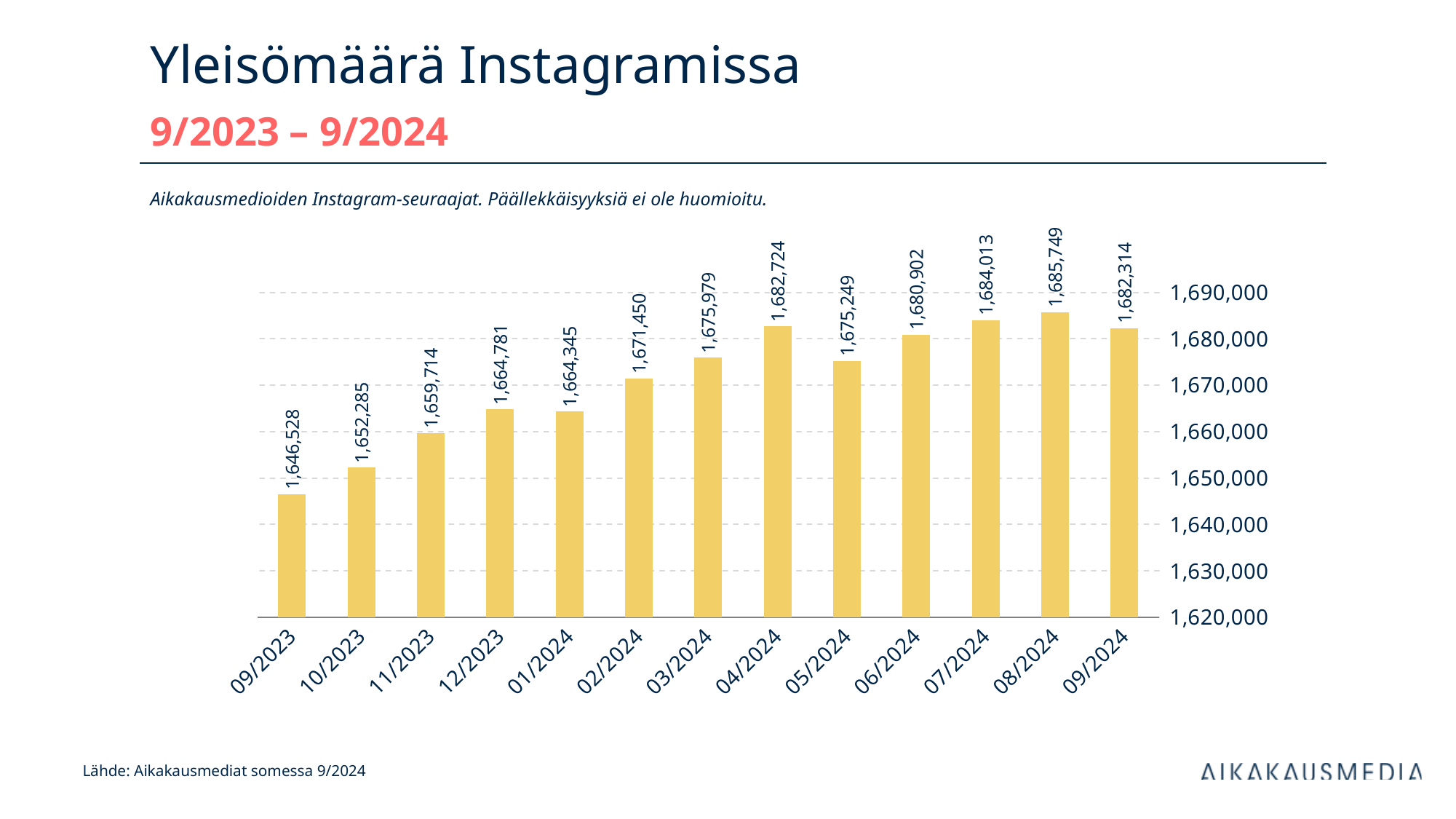
Which month has the highest value? 08/2024 What is the difference between the values for 09/2024 and 09/2023? 35,786 What is the value for 09/2023? 1,646,528 What is the value for 04/2024? 1,682,724 What is the difference between the values for 08/2024 and 07/2024? 1,736 How many months are shown on the x axis? 13 What is the value for 09/2024? 1,682,314 Which is larger, the value for 04/2024 or the value for 05/2024? 04/2024 Do the values generally rise or fall from 09/2023 to 09/2024? rise Is the value for 09/2023 greater or less than 1,650,000? less Which month has the lowest value? 09/2023 What kind of chart is shown on the slide? bar chart